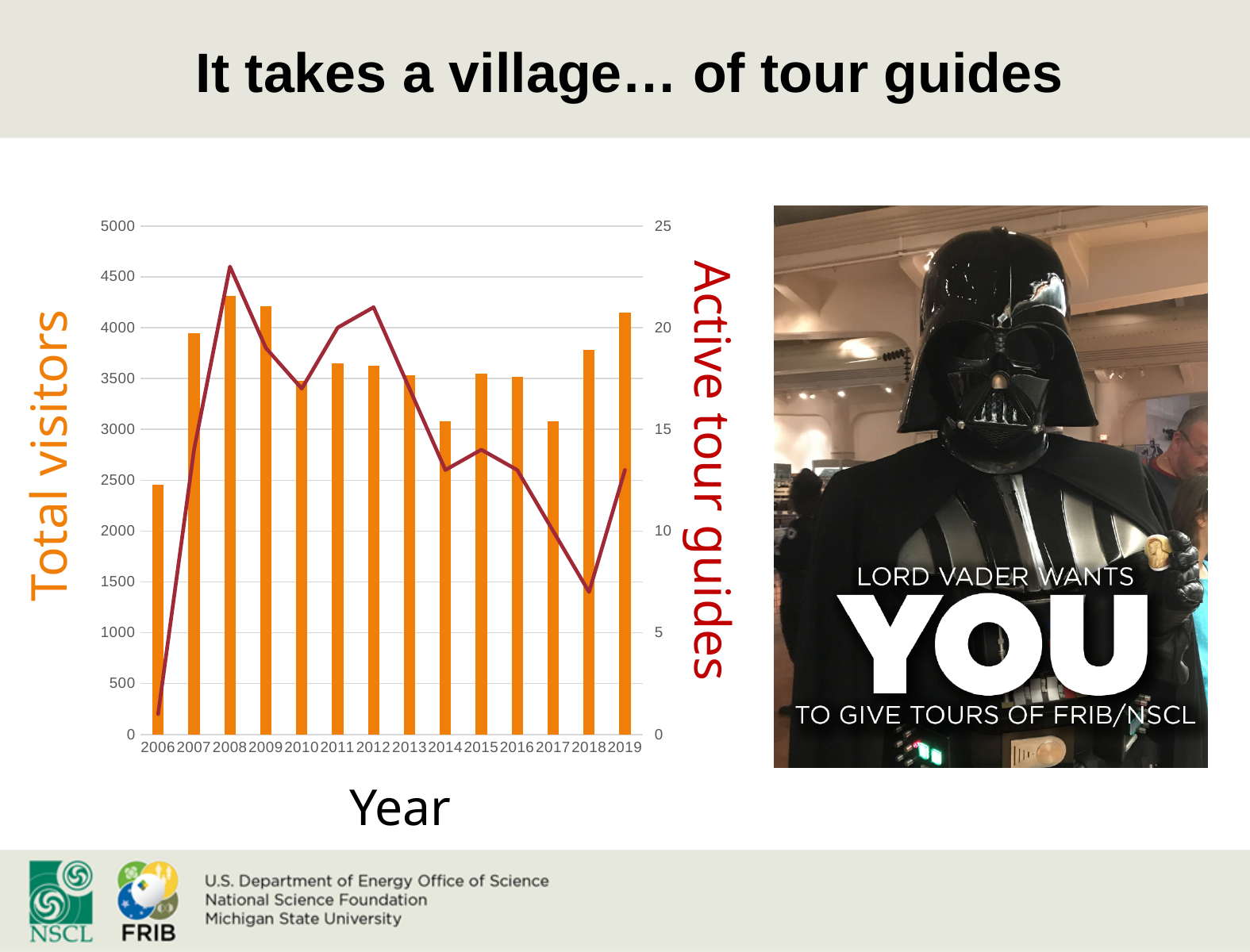
Is the active tour guides value for 2008 greater or less than 20? greater Which year has the lowest total visitors bar? 2006 In which year does the active tour guides line reach its lowest point? 2006 In which year does the active tour guides line reach its highest point? 2008 Which year has more total visitors, 2006 or 2007? 2007 How many years are shown on the x axis of the chart? 14 Which year has the highest total visitors bar? 2008 Is the total visitors value for 2006 greater or less than 3000? less Is the active tour guides value for 2018 greater or less than 10? less What is the label on the left vertical axis of the chart? Total visitors What kind of chart is shown on the slide? A bar chart combined with a line chart